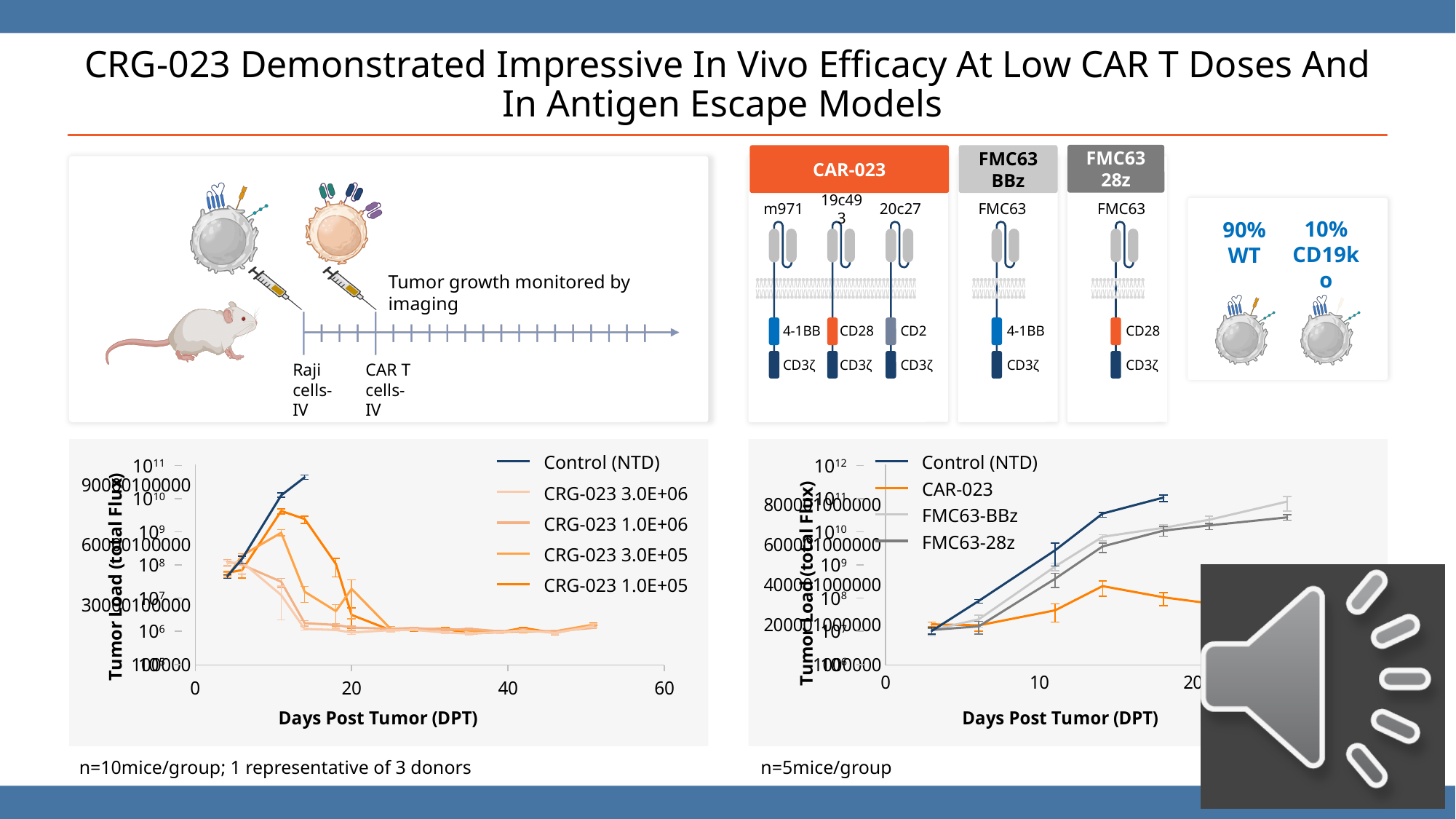
What is the y-axis title of the right chart? Tumor Load (total Flux) In the right chart, which series has the lowest tumor load at the last plotted time points? CAR-023 In the right chart, does the Control (NTD) series rise or fall along the x axis? rise In the right chart, which series is higher at around day 18: FMC63-BBz or CAR-023? FMC63-BBz In the right chart, which series is higher at around day 14: Control (NTD) or CAR-023? Control (NTD) How many series does the legend of the right chart list? 4 What kind of chart is the left chart (n=10 mice/group)? line chart What is the x-axis title of the left chart? Days Post Tumor (DPT) In the left chart, do the CRG-023 series rise or fall after about day 20? fall What kind of chart is the right chart (n=5 mice/group)? line chart How many series does the legend of the left chart list? 5 In the left chart, which series reaches the highest tumor load? Control (NTD)